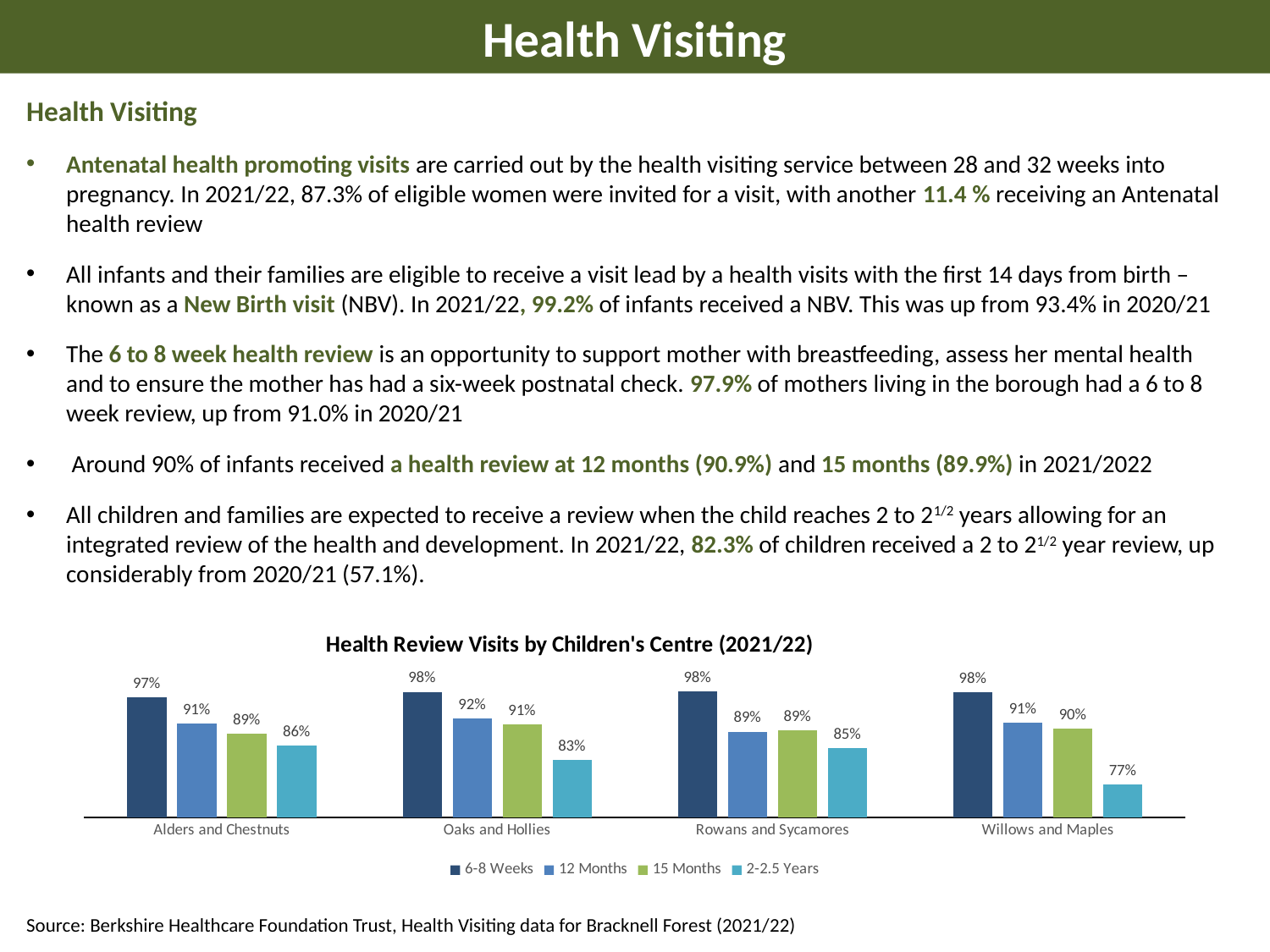
What is the 6-8 Weeks value for Alders and Chestnuts? 97% Which is larger for Alders and Chestnuts: the 12 Months value or the 2-2.5 Years value? 12 Months Which children's centre has the highest 12 Months value? Oaks and Hollies How many children's centres are shown on the x axis? 4 What is the difference between the 6-8 Weeks and 2-2.5 Years values for Oaks and Hollies? 15% How many series does the legend list? 4 What is the title of the chart? Health Review Visits by Children's Centre (2021/22) What is the 2-2.5 Years value for Willows and Maples? 77% What kind of chart is shown on the slide? Bar chart What is the 12 Months value for Oaks and Hollies? 92% What is the 15 Months value for Rowans and Sycamores? 89% Which children's centre has the lowest 2-2.5 Years value? Willows and Maples